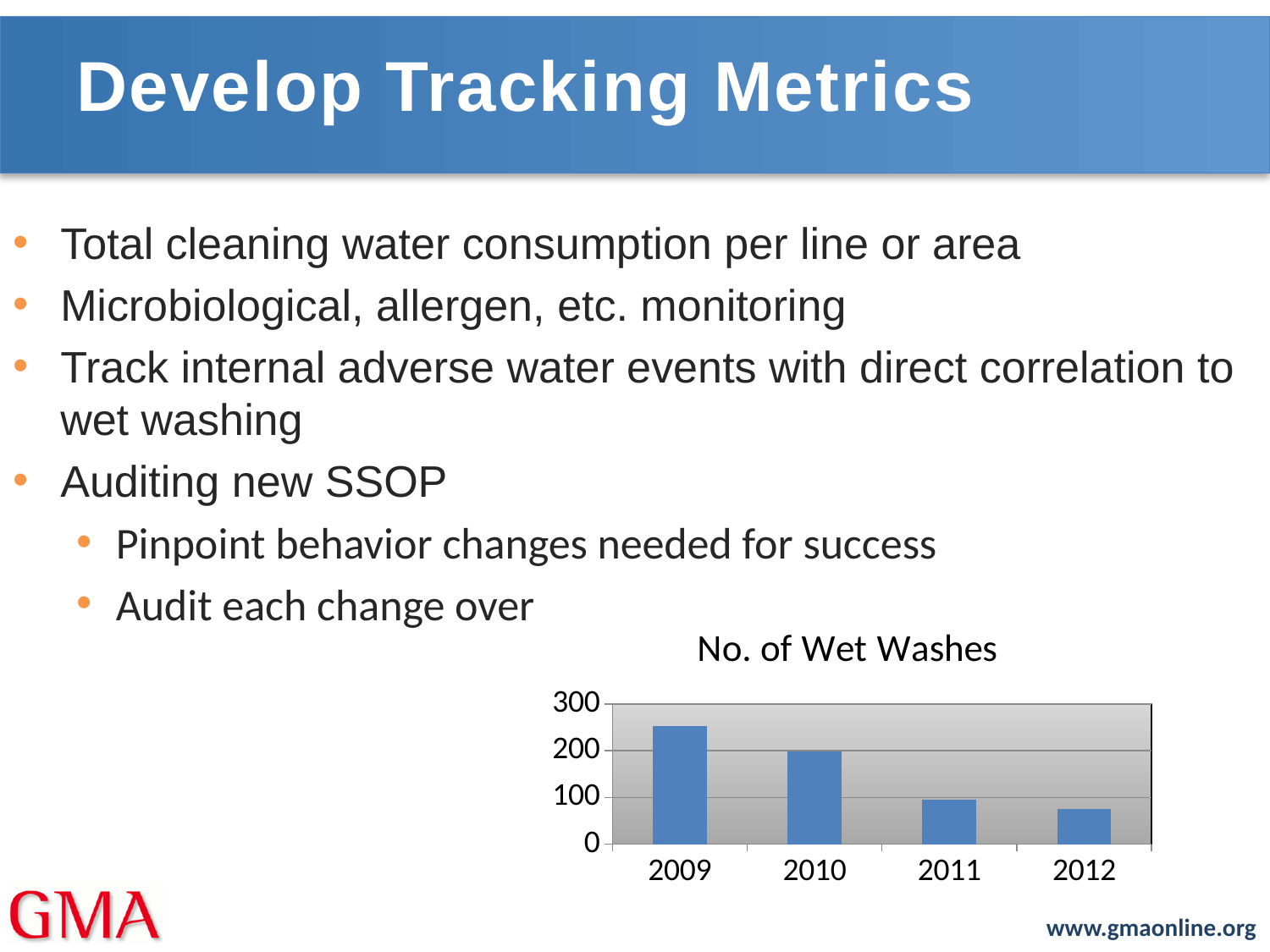
Is the value for 2011 greater or less than 200? less Is the value for 2009 greater or less than 200? greater What is the highest value shown on the y axis of the chart? 300 Do the number of wet washes rise or fall from 2009 to 2012? fall Which year has the lowest number of wet washes? 2012 How many years are shown on the x axis of the chart? 4 What type of chart is shown on the slide? bar chart Is the value for 2012 greater or less than 100? less What is the title of the chart? No. of Wet Washes Which year has more wet washes, 2010 or 2011? 2010 Which year has the highest number of wet washes? 2009